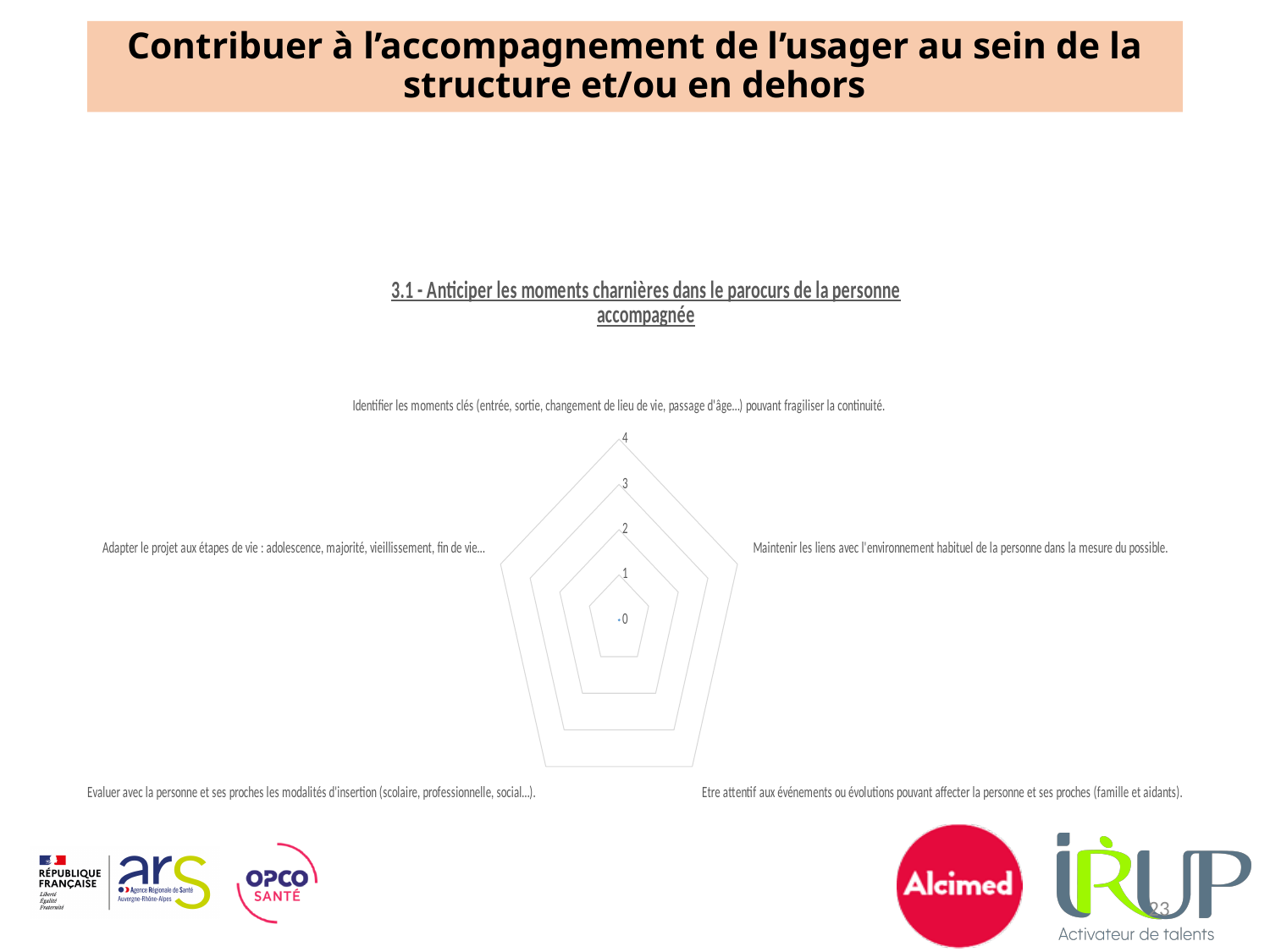
What is the lowest value shown on the radar chart's axis scale? 0 Which category label is placed on the right side of the radar chart? Maintenir les liens avec l'environnement habituel de la personne dans la mesure du possible. Which category label is placed on the left side of the radar chart? Adapter le projet aux étapes de vie : adolescence, majorité, vieillissement, fin de vie... How many categories (axes) does the radar chart have? 5 What is the title of the radar chart? 3.1 - Anticiper les moments charnières dans le parocurs de la personne accompagnée What kind of chart is shown on the slide? Radar chart Which category label is placed at the top of the radar chart? Identifier les moments clés (entrée, sortie, changement de lieu de vie, passage d'âge...) pouvant fragiliser la continuité. What is the highest value shown on the radar chart's axis scale? 4